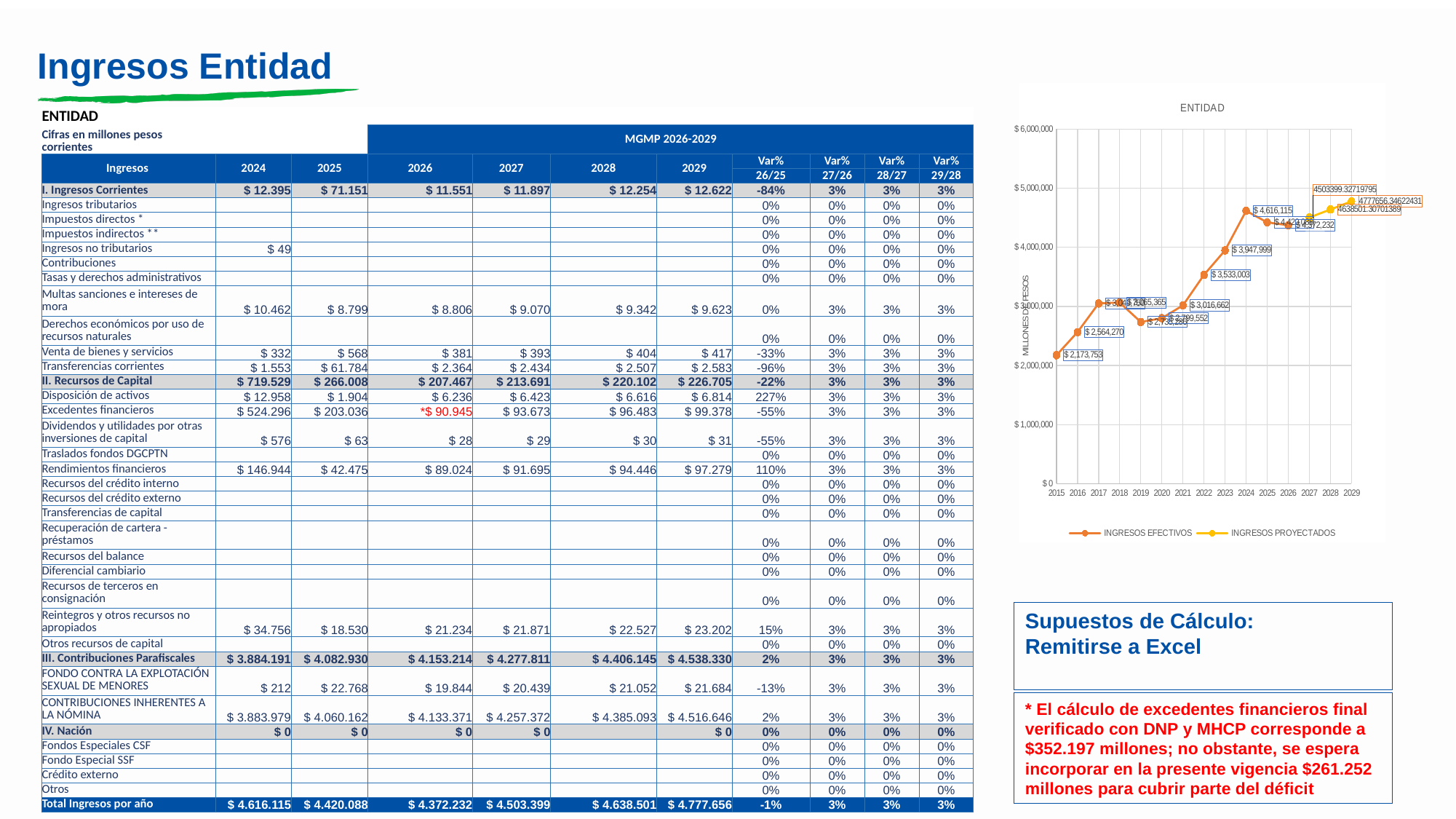
Which is larger in the chart, the value for 2022 or the value for 2016? 2022 What is the value plotted for 2024 in the chart? $4,616,115 Do the values in the chart generally rise or fall from 2015 to 2029? rise Which year has the lowest value in the chart? 2015 What is the value plotted for 2015 in the chart? $2,173,753 What is the value plotted for 2016 in the chart? $2,564,270 Is the value for 2015 greater or less than $3,000,000? less What are the two series named in the chart legend? INGRESOS EFECTIVOS and INGRESOS PROYECTADOS What is the value plotted for 2022 in the chart? $3,533,003 What type of chart is shown on the slide? line chart What is the difference between the 2024 value and the 2023 value in the chart? $668,116 How many series does the chart legend list? 2